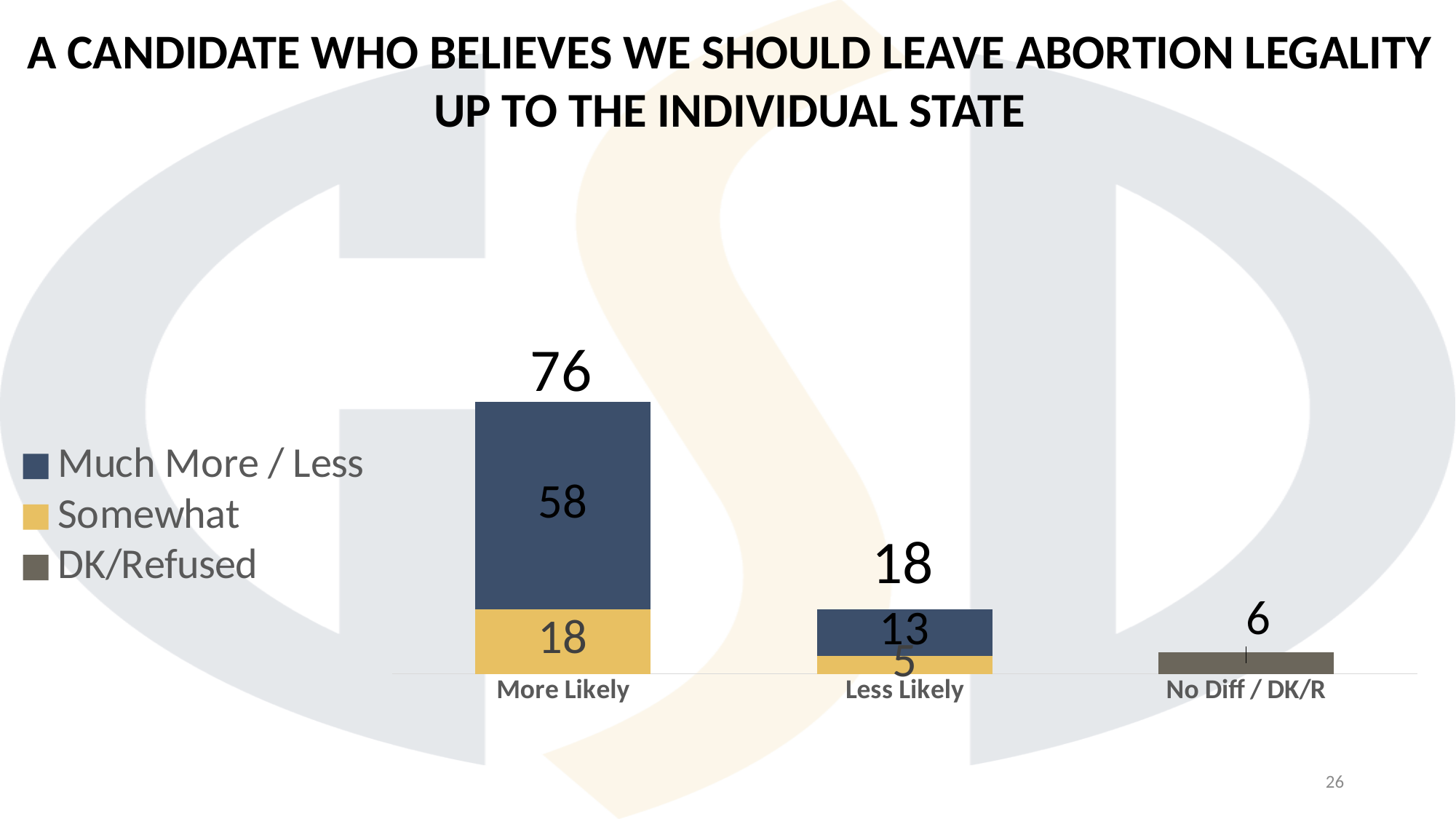
What is the 'Somewhat' value for the 'Less Likely' bar? 5 What is the 'Somewhat' value for the 'More Likely' bar? 18 What is the total of the 'More Likely' stacked bar? 76 Which category has the lowest total? No Diff / DK/R What is the value for the 'No Diff / DK/R' bar? 6 What is the 'Much More / Less' value for the 'Less Likely' bar? 13 What is the total of the 'Less Likely' stacked bar? 18 What is the difference between the 'More Likely' total and the 'Less Likely' total? 58 What kind of chart is shown on the slide? Stacked bar chart Which category has the highest total? More Likely How many series does the legend list? 3 What is the 'Much More / Less' value for the 'More Likely' bar? 58